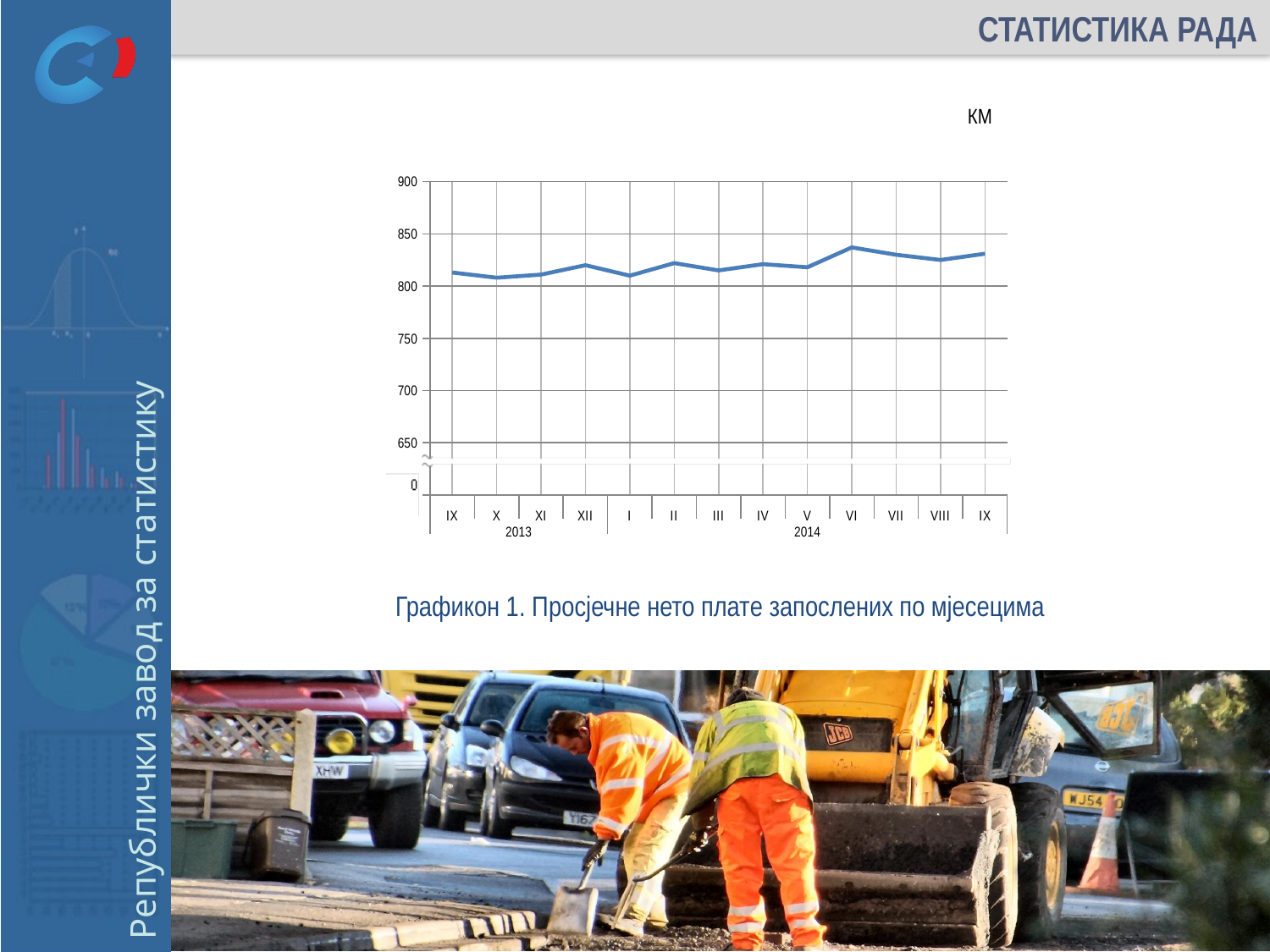
What unit is indicated above the chart? КМ What kind of chart is shown on the slide? line chart How many monthly data points are plotted on the chart? 13 Which month has the highest average net wage on the chart? VI 2014 Comparing IX 2013 with IX 2014, did the average net wage rise or fall? rise Is the value for I 2014 greater or less than 750? greater What is the caption of the chart? Графикон 1. Просјечне нето плате запослених по мјесецима Which is larger, the value for V 2014 or the value for VI 2014? VI 2014 Is the value for VI 2014 greater or less than 850? less Is the value for X 2013 greater or less than 800? greater Which is larger, the value for VI 2014 or the value for X 2013? VI 2014